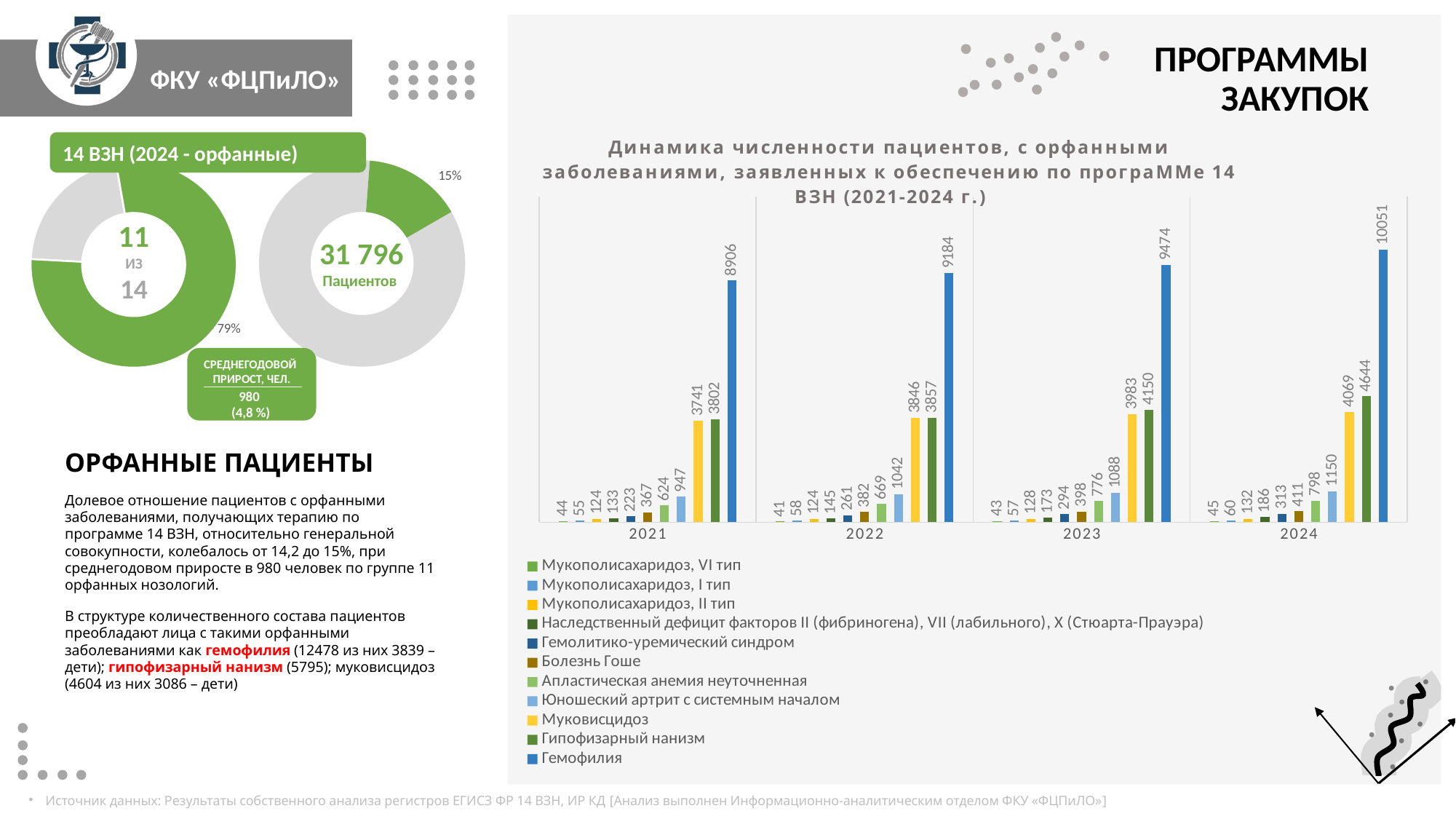
In the chart 'Динамика численности пациентов...', how many series does the legend list? 11 In the chart 'Динамика численности пациентов...', does the value for Гемофилия rise or fall from 2021 to 2024? rise In the chart 'Динамика численности пациентов...', which is larger in 2022: Муковисцидоз or Гипофизарный нанизм? Гипофизарный нанизм In the chart 'Динамика численности пациентов...', what is the value for Муковисцидоз in 2021? 3741 What type of chart is 'Динамика численности пациентов, с орфанными заболеваниями...'? bar chart In the chart 'Динамика численности пациентов...', which series has the highest value in 2024? Гемофилия In the chart 'Динамика численности пациентов...', how many years are shown on the x axis? 4 In the chart 'Динамика численности пациентов, с орфанными заболеваниями...', what is the value for Гемофилия in 2024? 10051 In the chart 'Динамика численности пациентов...', what is the value for Болезнь Гоше in 2022? 382 In the chart 'Динамика численности пациентов...', which series has the lowest value in 2021? Мукополисахаридоз, VI тип In the chart 'Динамика численности пациентов...', what is the value for Гипофизарный нанизм in 2023? 4150 In the chart 'Динамика численности пациентов...', what is the difference between the Гемофилия values for 2024 and 2021? 1145